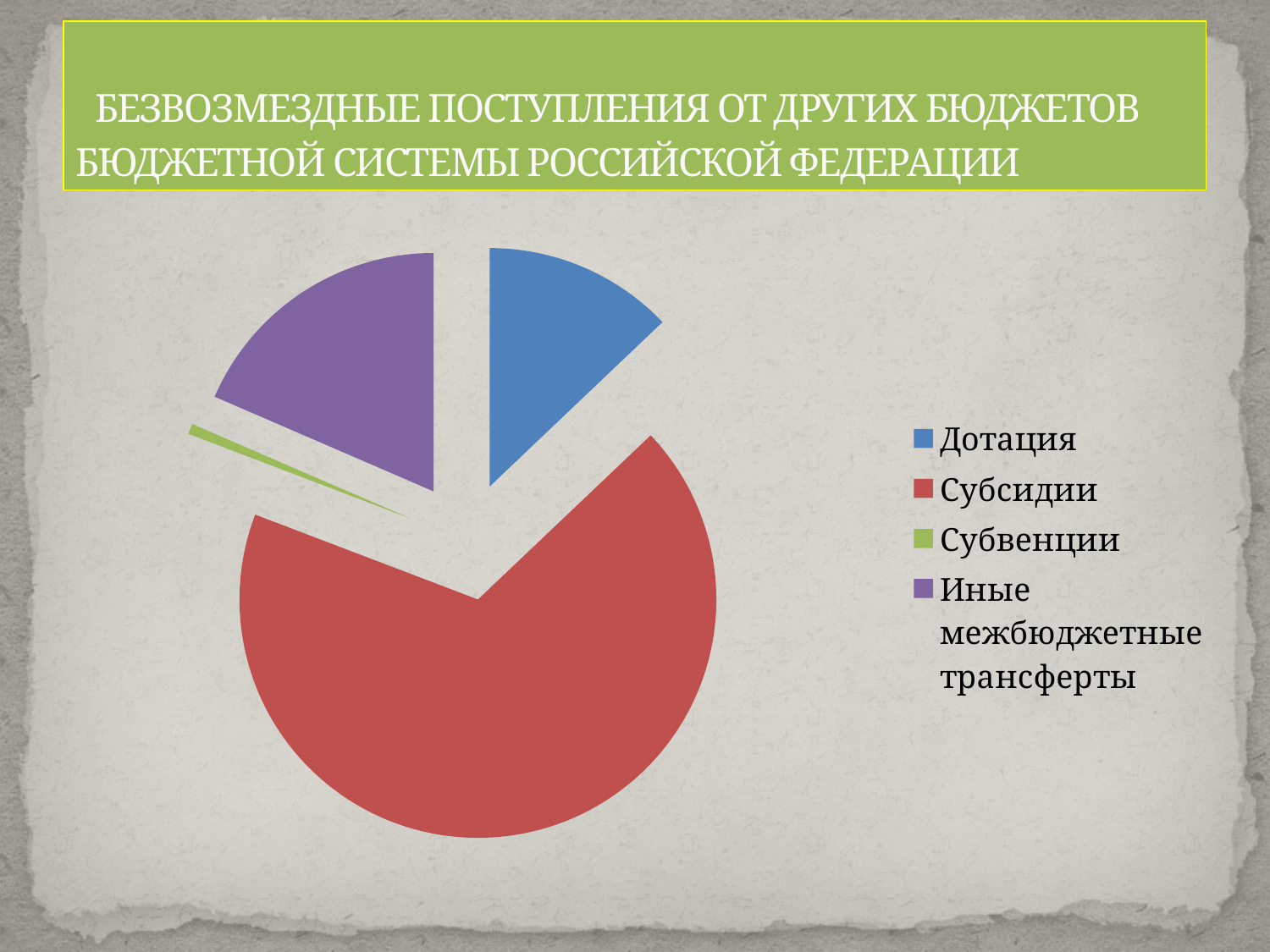
Which category has the smallest slice of the pie? Субвенции Does the Субсидии slice make up more or less than half of the pie? more What colour is the Субсидии slice in the pie chart? red Which slice is larger, Дотация or Субвенции? Дотация How many entries does the legend list? 4 What kind of chart is shown on the slide? pie chart Which slice is larger, Субсидии or Дотация? Субсидии How many slices does the pie chart have? 4 What is the title of the slide containing the chart? БЕЗВОЗМЕЗДНЫЕ ПОСТУПЛЕНИЯ ОТ ДРУГИХ БЮДЖЕТОВ БЮДЖЕТНОЙ СИСТЕМЫ РОССИЙСКОЙ ФЕДЕРАЦИИ Which category has the largest slice of the pie? Субсидии